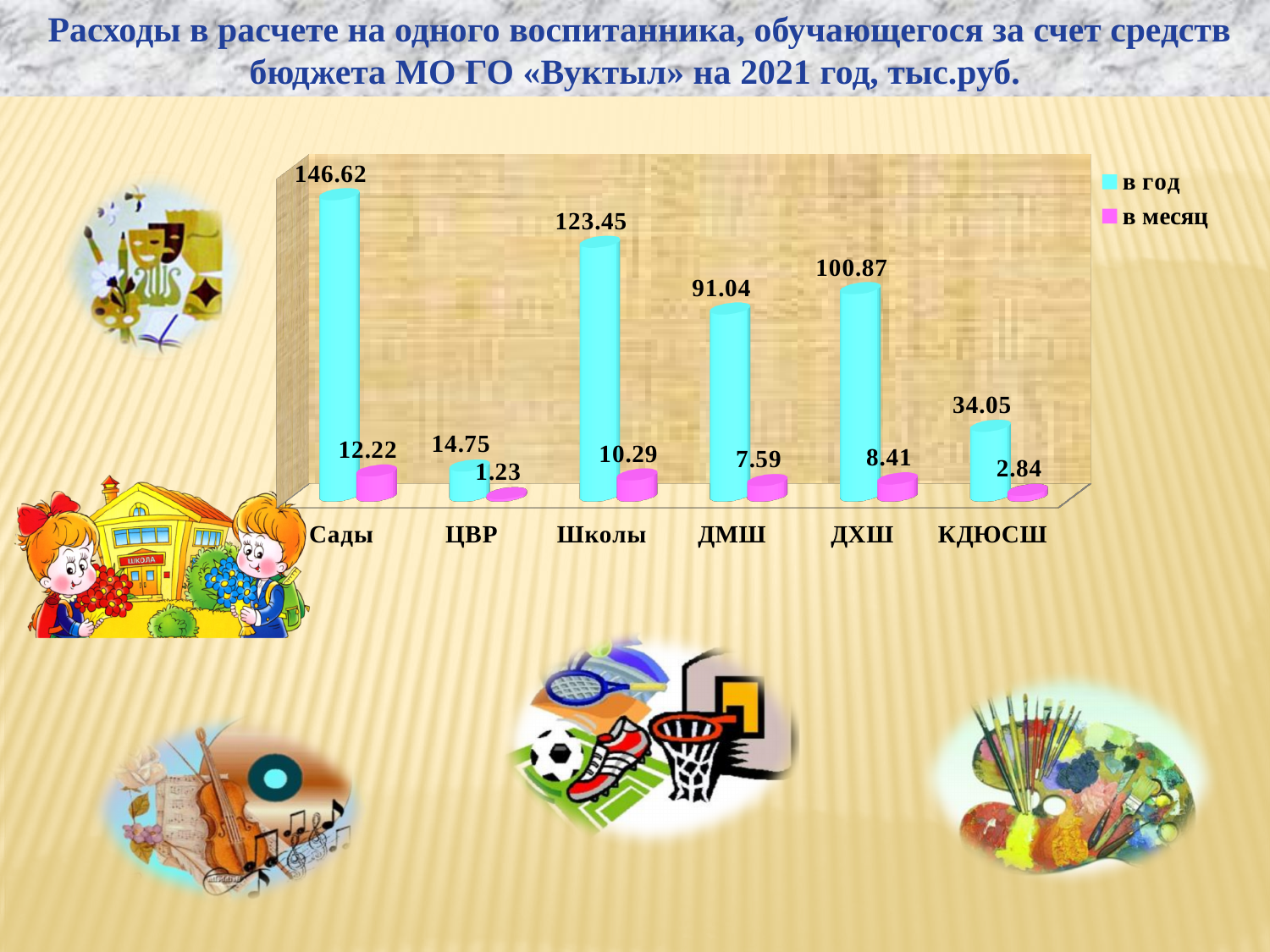
What is the value for Сады in the 'в год' series? 146.62 Which is larger, the 'в год' value for ДХШ or for ДМШ? ДХШ What is the value for Школы in the 'в год' series? 123.45 What is the value for ЦВР in the 'в месяц' series? 1.23 How many series does the legend list? 2 How many categories are shown on the x axis? 6 What is the value for КДЮСШ in the 'в месяц' series? 2.84 Which category has the lowest 'в год' value? ЦВР Which category has the highest 'в год' value? Сады What is the difference between the 'в год' values for Школы and ДМШ? 32.41 What kind of chart is shown on the slide? bar chart What are the two legend entries of the chart? в год, в месяц